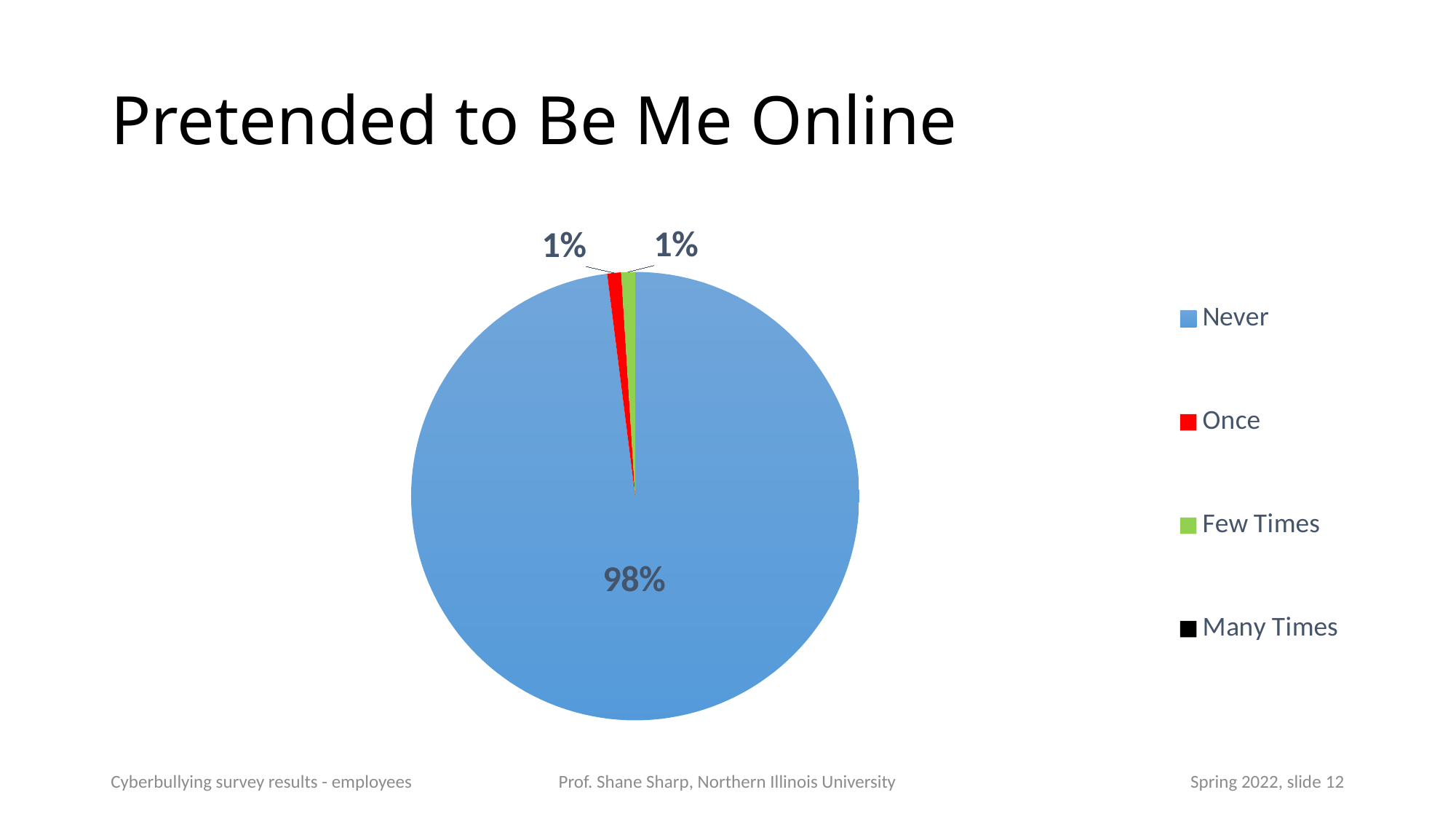
What share of the pie does the Never slice represent? 98% How many percentage data labels are printed on the pie? 3 What kind of chart is shown on the slide? pie chart What is the difference between the Never share and the Once share? 97% How many categories does the legend list? 4 What colour is used for the Never slice? blue Which is larger, the share for Never or the share for Once? Never What percentage is shown for the Few Times slice? 1% Which category has the largest share of the pie? Never What percentage is shown for the Once slice? 1% What is the title of the slide containing the chart? Pretended to Be Me Online